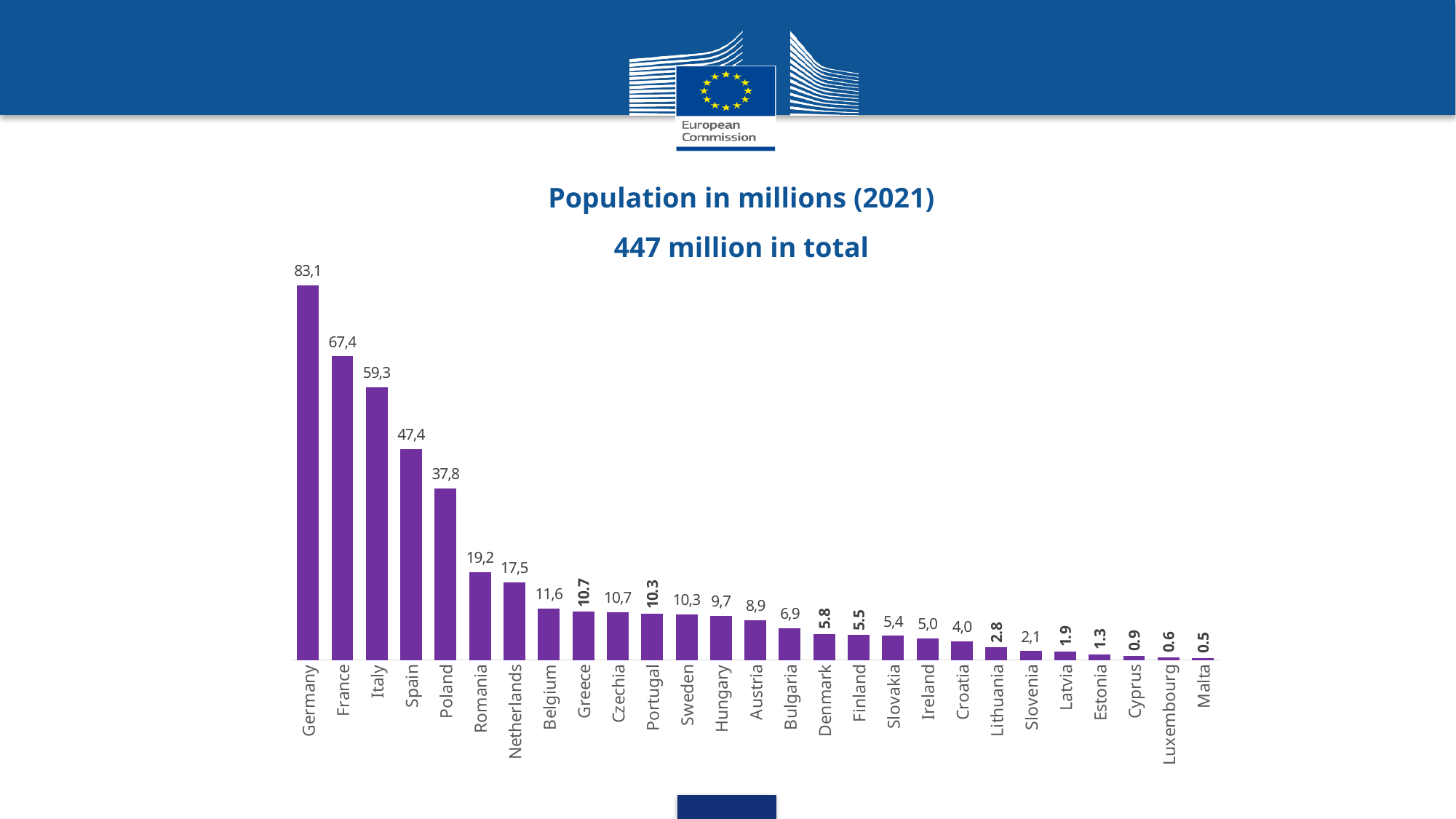
Which has a larger value, Romania or Netherlands? Romania What kind of chart is shown on the slide? Bar chart Do the values rise or fall from left to right along the x axis? Fall What is the difference between the values for Germany and France? 15,7 What is the difference between the values for Spain and Poland? 9,6 How many countries are shown in the chart? 27 Which country has the lowest population in the chart? Malta What is the population value shown for Poland? 37,8 What is the population value shown for Malta? 0.5 Which country has the highest population in the chart? Germany What is the population value shown for Denmark? 5.8 What is the population value shown for Germany? 83,1